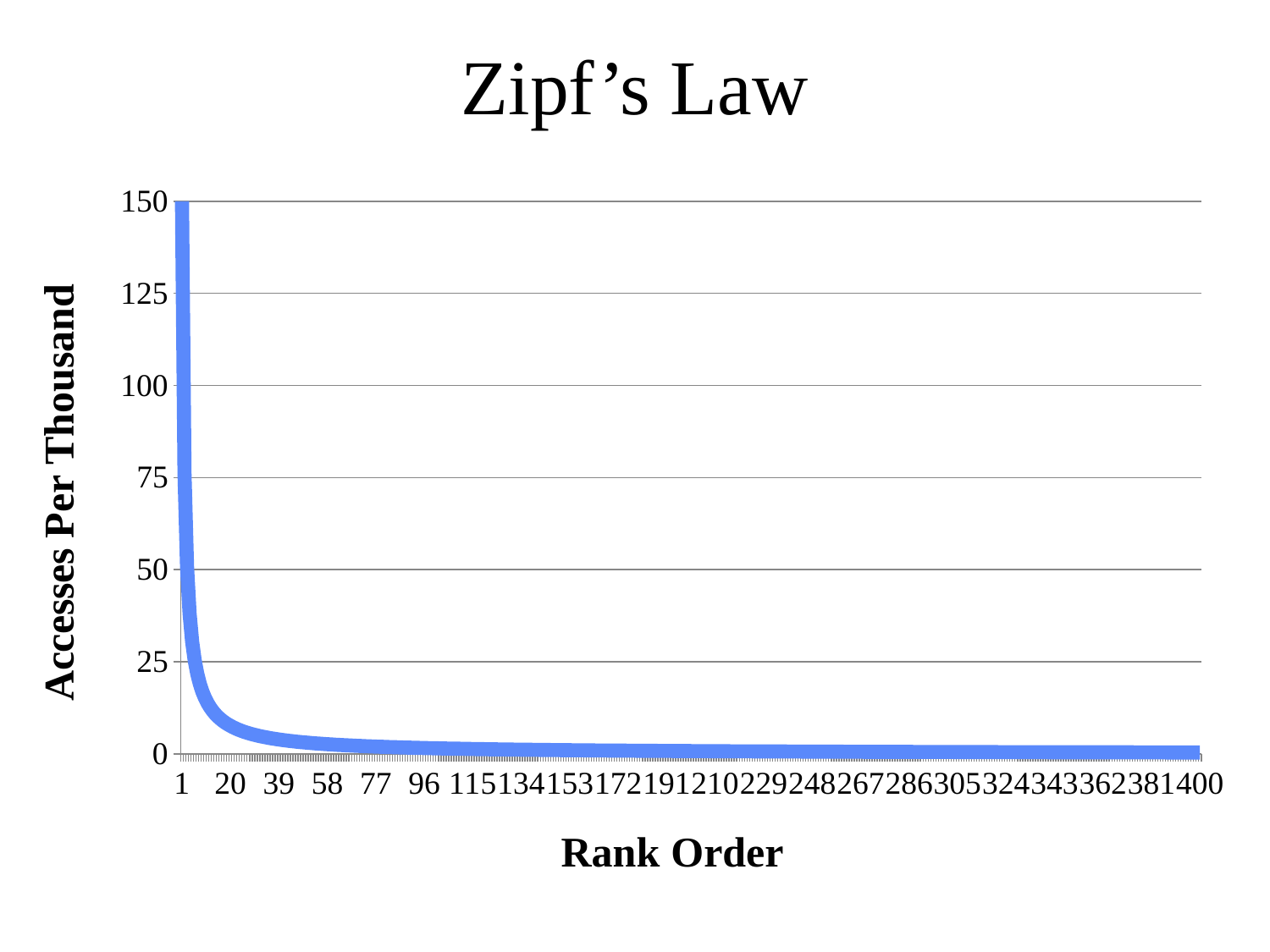
Is the value at rank order 20 greater or less than 25? less Which has the larger value, rank order 1 or rank order 400? rank order 1 Do the values rise or fall as rank order increases along the x axis? fall What kind of chart is shown on the slide? line chart At which rank order is the value highest? 1 What is the title of the chart? Zipf's Law What is the highest value shown on the y axis? 150 Is the value at rank order 1 greater or less than 125? greater Is the value at rank order 200 greater or less than 50? less What is the label of the y axis? Accesses Per Thousand